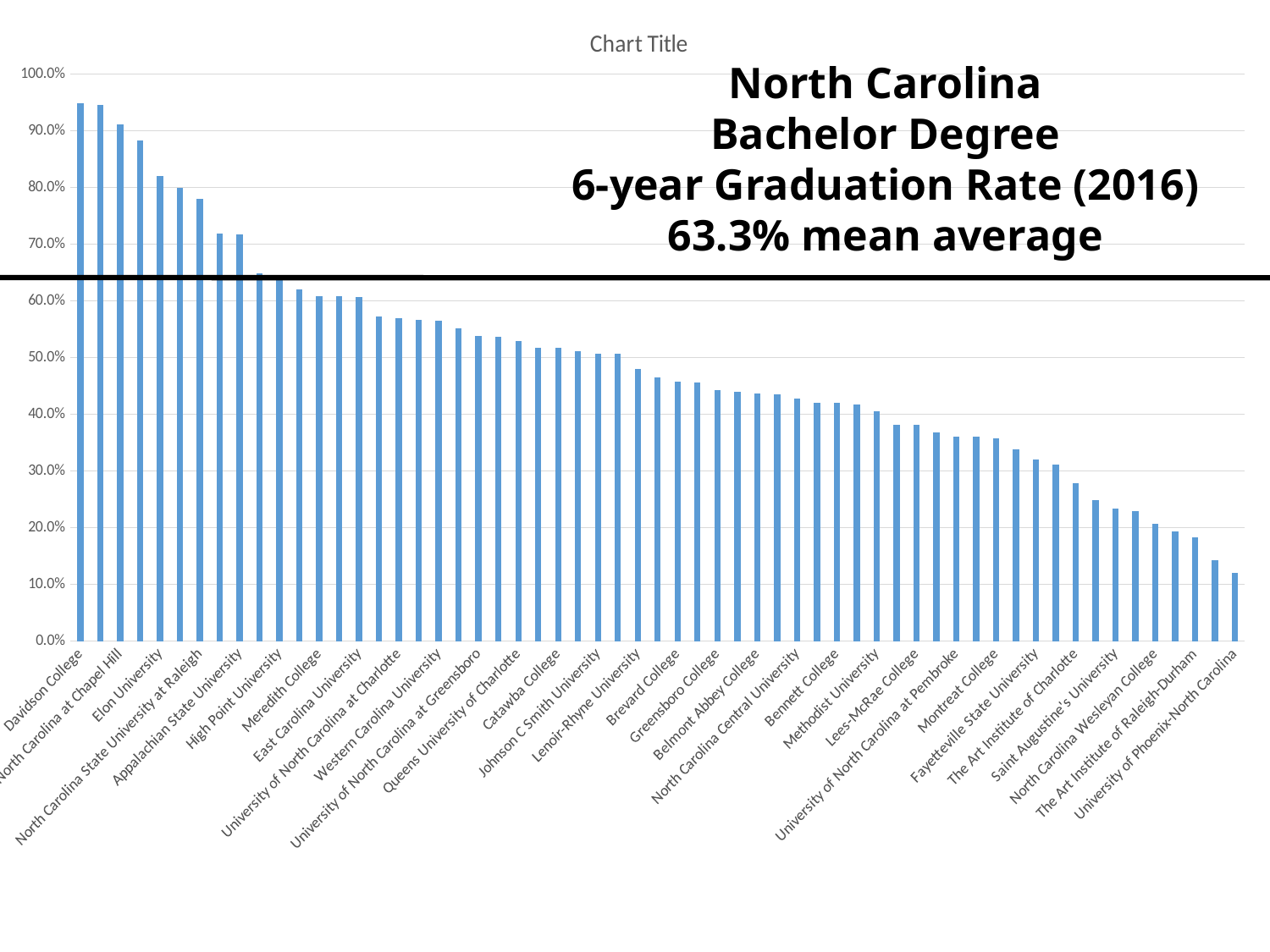
Is the value for Fayetteville State University greater or less than 40.0%? less What year does the graduation rate data on the slide refer to? 2016 What mean average graduation rate is stated on the slide? 63.3% Is the value for University of Phoenix-North Carolina greater or less than 20.0%? less Which institution has the lowest 6-year graduation rate on the chart? University of Phoenix-North Carolina What kind of chart is shown on the slide? bar chart Is the value for Davidson College greater or less than 90.0%? greater Which institution has the highest 6-year graduation rate on the chart? Davidson College Which has the larger graduation rate, Davidson College or University of Phoenix-North Carolina? Davidson College Do the graduation rates rise or fall moving from left to right along the x axis? fall